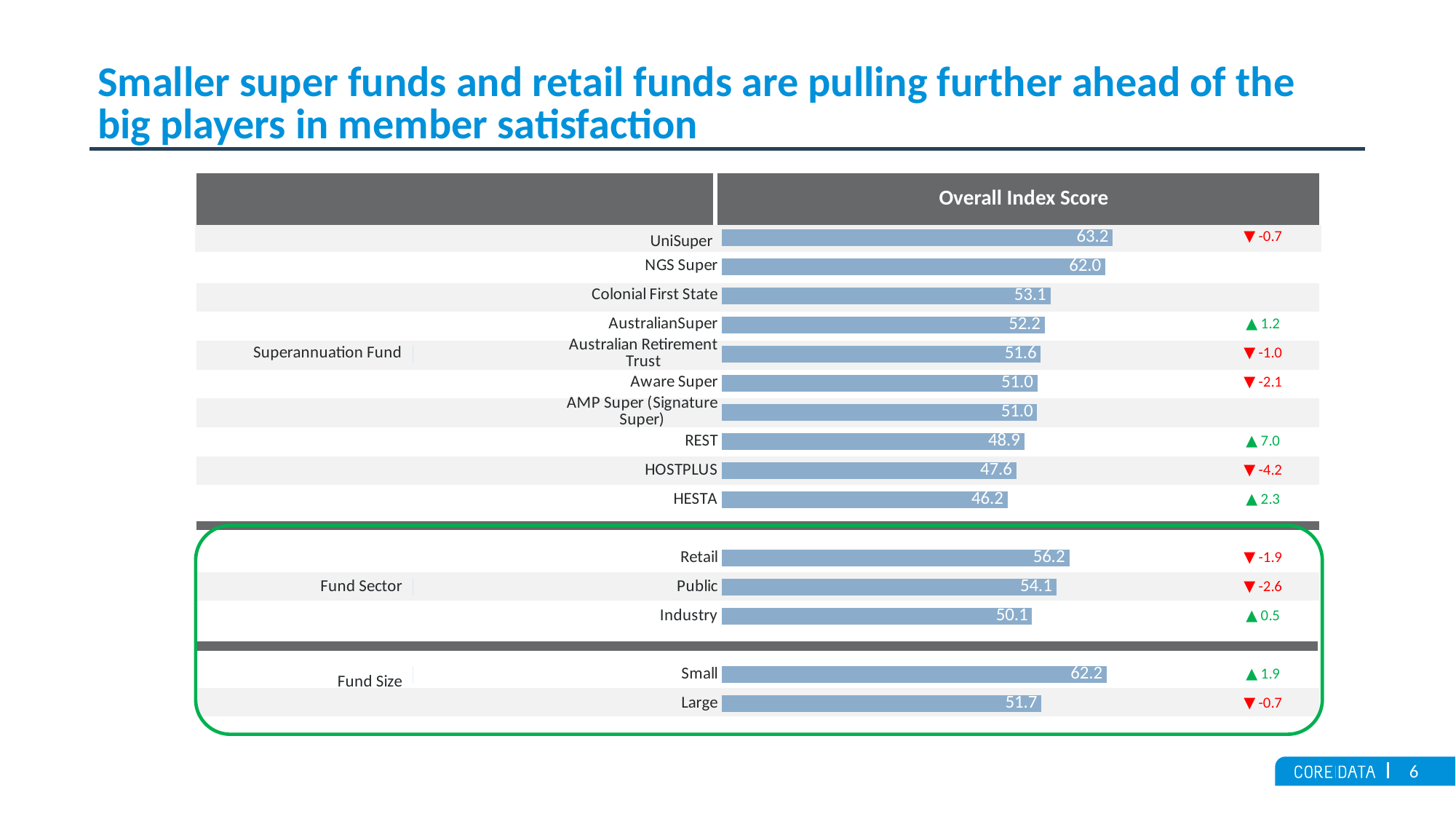
What is the Overall Index Score for UniSuper? 63.2 What is the difference in Overall Index Score between Small and Large funds? 10.5 What kind of chart is used to show the Overall Index Score? Bar chart What is the change shown next to REST's Overall Index Score? ▲ 7.0 What is the difference in Overall Index Score between UniSuper and NGS Super? 1.2 Which superannuation fund has the lowest Overall Index Score? HESTA What is the Overall Index Score for the Retail fund sector? 56.2 How many superannuation funds are listed in the Superannuation Fund section? 10 Which superannuation fund has the highest Overall Index Score? UniSuper What is the Overall Index Score for HOSTPLUS? 47.6 Which has a higher Overall Index Score, Public or Industry? Public What is the title of the column containing the bars? Overall Index Score